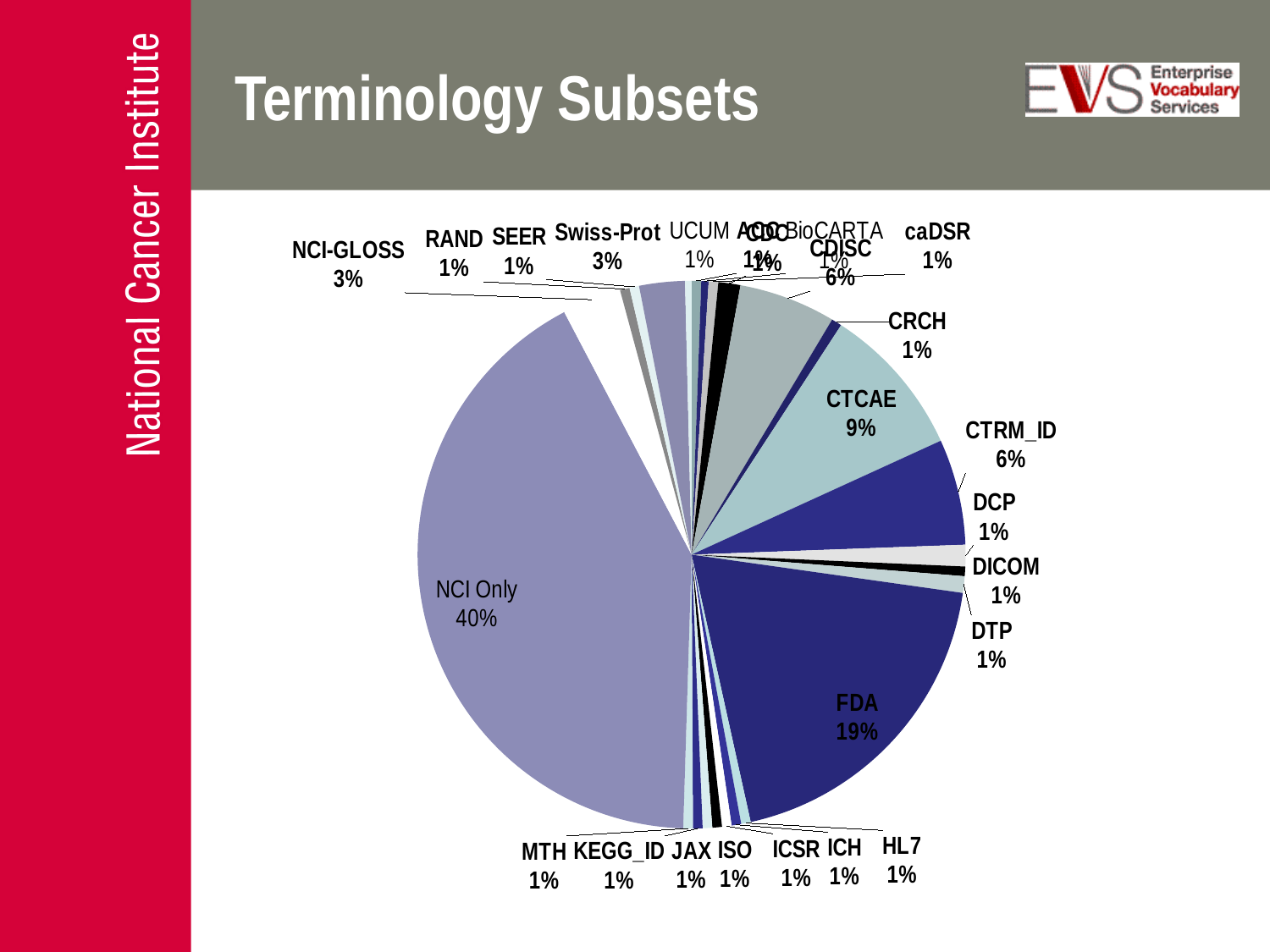
Which slice of the pie is the largest? NCI Only What kind of chart is shown on the slide? pie chart What percentage is shown for Swiss-Prot? 3% What is the title of the chart on the slide? Terminology Subsets What percentage does the FDA slice represent? 19% What is the difference in percentage points between the NCI Only slice and the FDA slice? 21% What is the value shown for CTRM_ID? 6% What percentage is shown for NCI-GLOSS? 3% What is the difference between the FDA slice and the CTCAE slice? 10% Which is larger, the CTCAE slice or the CTRM_ID slice? CTCAE What is the value shown for CTCAE? 9% What percentage of the pie is labelled NCI Only? 40%